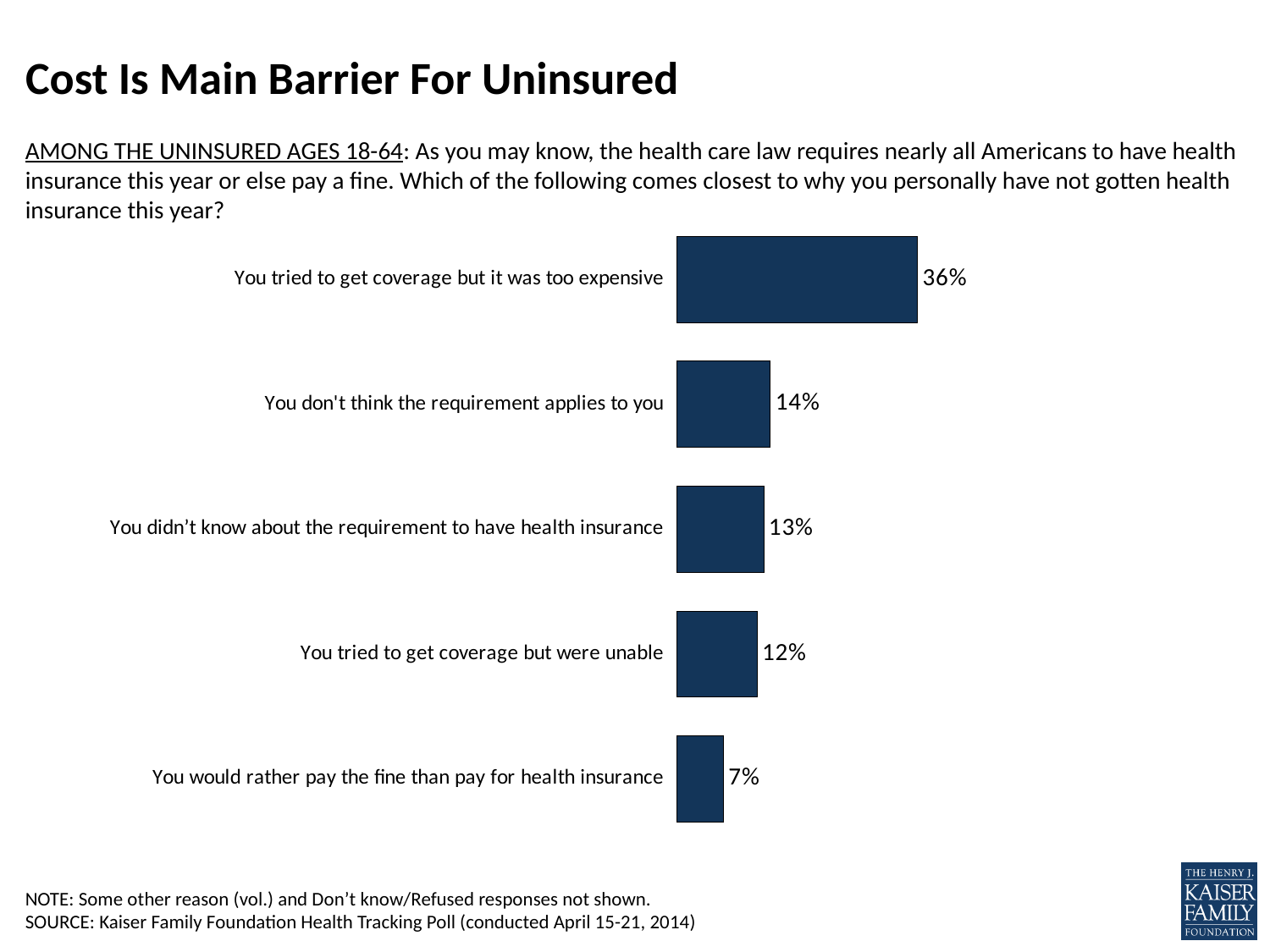
What percentage said they tried to get coverage but were unable? 12% How many reasons are shown in the chart? 5 Which reason has the lowest percentage? You would rather pay the fine than pay for health insurance What type of chart is shown on the slide? Bar chart What percentage of uninsured respondents said they tried to get coverage but it was too expensive? 36% What percentage said they would rather pay the fine than pay for health insurance? 7% What is the difference in percentage points between 'tried to get coverage but it was too expensive' and 'would rather pay the fine than pay for health insurance'? 29 percentage points What percentage said they didn't know about the requirement to have health insurance? 13% Which reason has the highest percentage? You tried to get coverage but it was too expensive What percentage said they don't think the requirement applies to them? 14% What is the title of the slide? Cost Is Main Barrier For Uninsured Which is larger: the percentage who don't think the requirement applies to them, or the percentage who tried to get coverage but were unable? You don't think the requirement applies to you